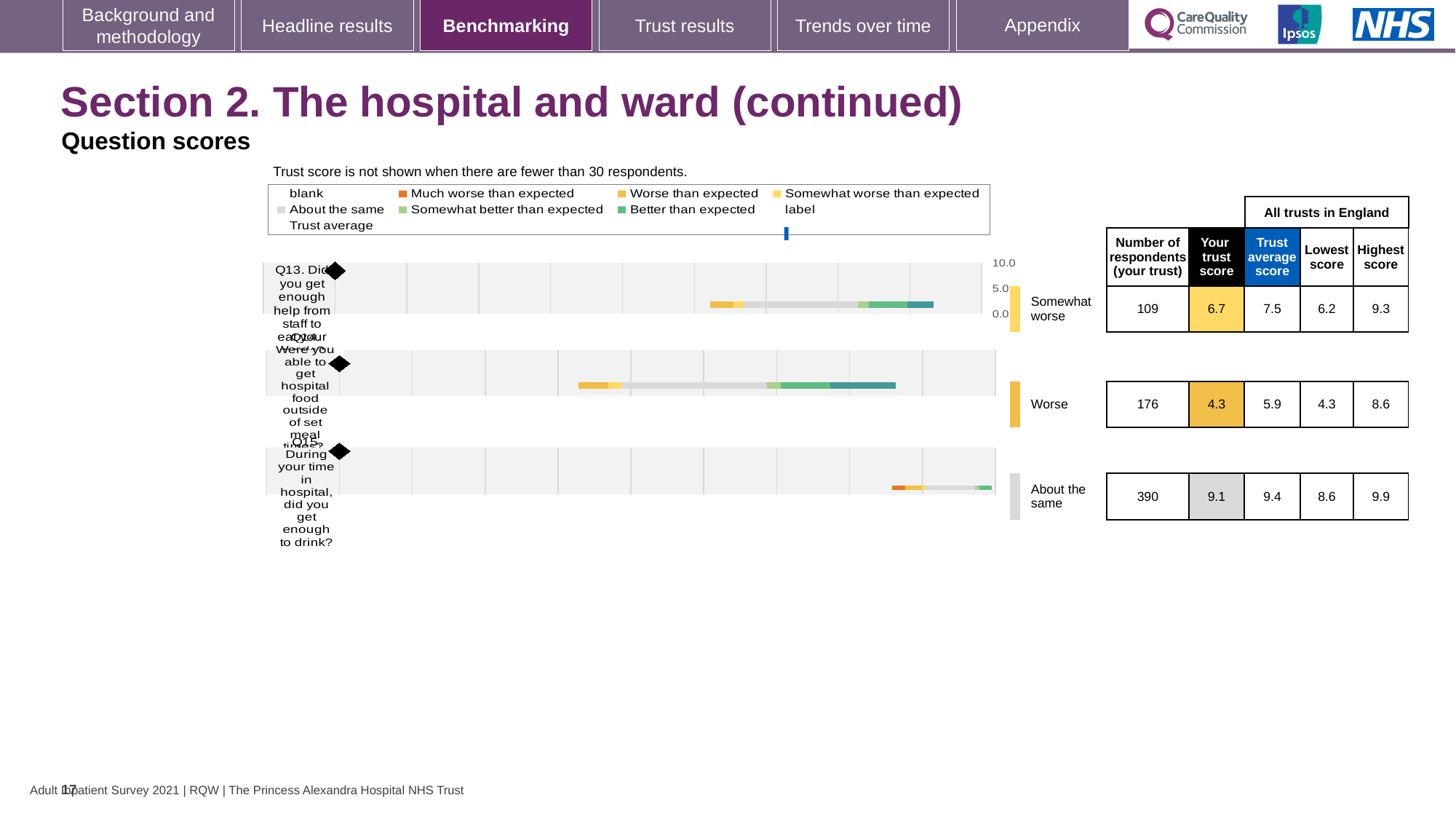
What is the trust score for Q15 (did you get enough to drink?)? 9.1 What is the trust score for Q14 (Were you able to get hospital food outside of set meal times?)? 4.3 Which has the larger trust score, Q13 or Q14? Q13 What is the trust average score across all trusts in England for Q13? 7.5 How many respondents answered Q14? 176 How many questions are plotted in the chart? 3 What benchmark category is shown for Q14? Worse Which question has the highest trust score? Q15 What is the difference between the trust scores for Q15 and Q14? 4.8 Which question has the lowest trust score? Q14 What kind of chart is used to show the question scores on this slide? bar chart What is the trust score for Q13 (Did you get enough help from staff to eat your meals?)? 6.7